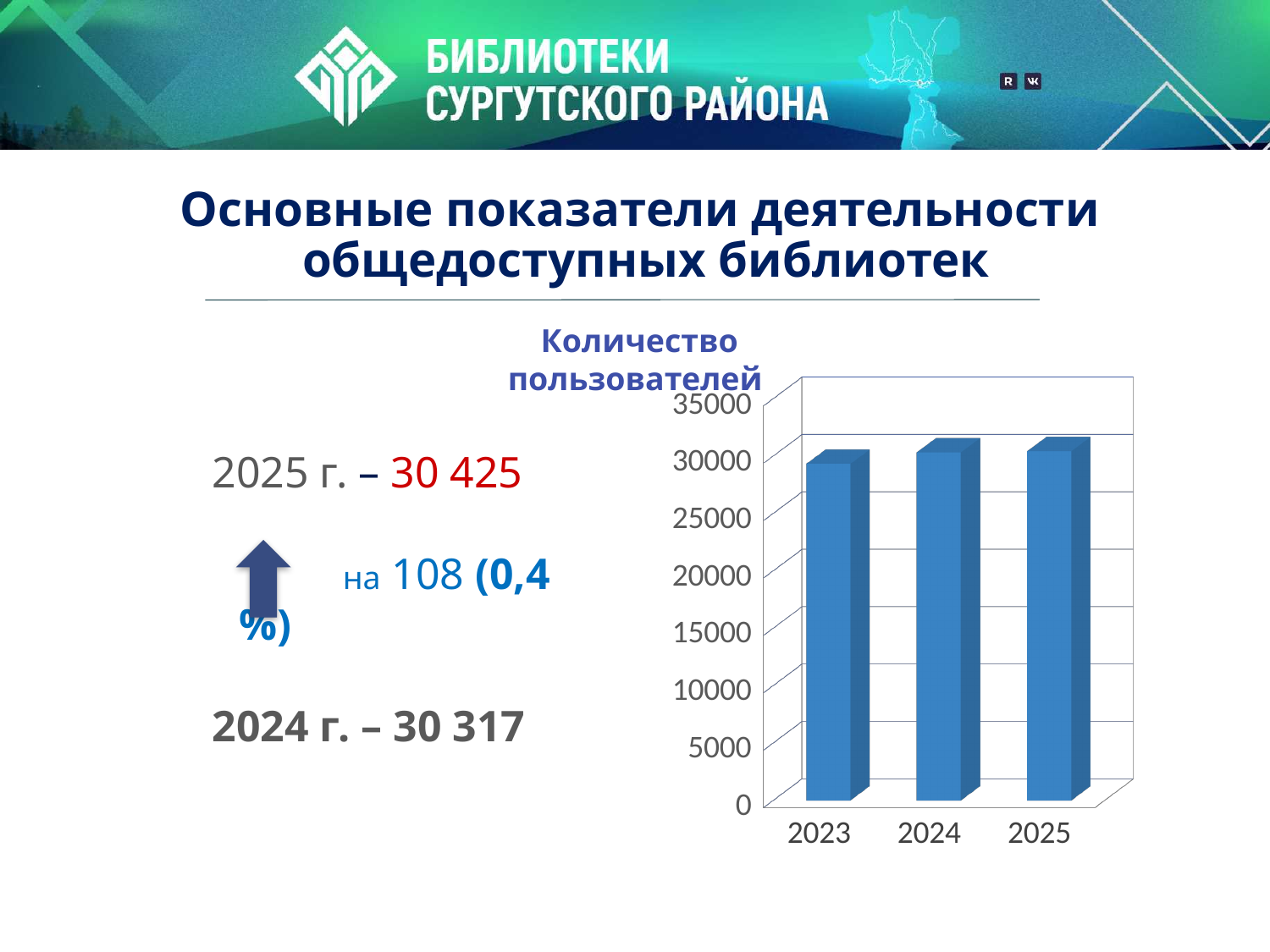
Is the value for 2024 greater or less than 35000? less Is the value for 2023 greater or less than 25000? greater Is the value for 2025 greater or less than 30000? greater How many years are shown on the x axis of the chart? 3 What kind of chart is shown on the slide? bar chart Which year has the lowest bar in the chart? 2023 Do the values rise or fall from 2023 to 2025? rise Which is larger, the value for 2023 or the value for 2025? 2025 What is the title of the chart? Количество пользователей What is the number of users for 2024? 30 317 What is the number of users for 2025? 30 425 By how much did the number of users increase from 2024 to 2025? 108